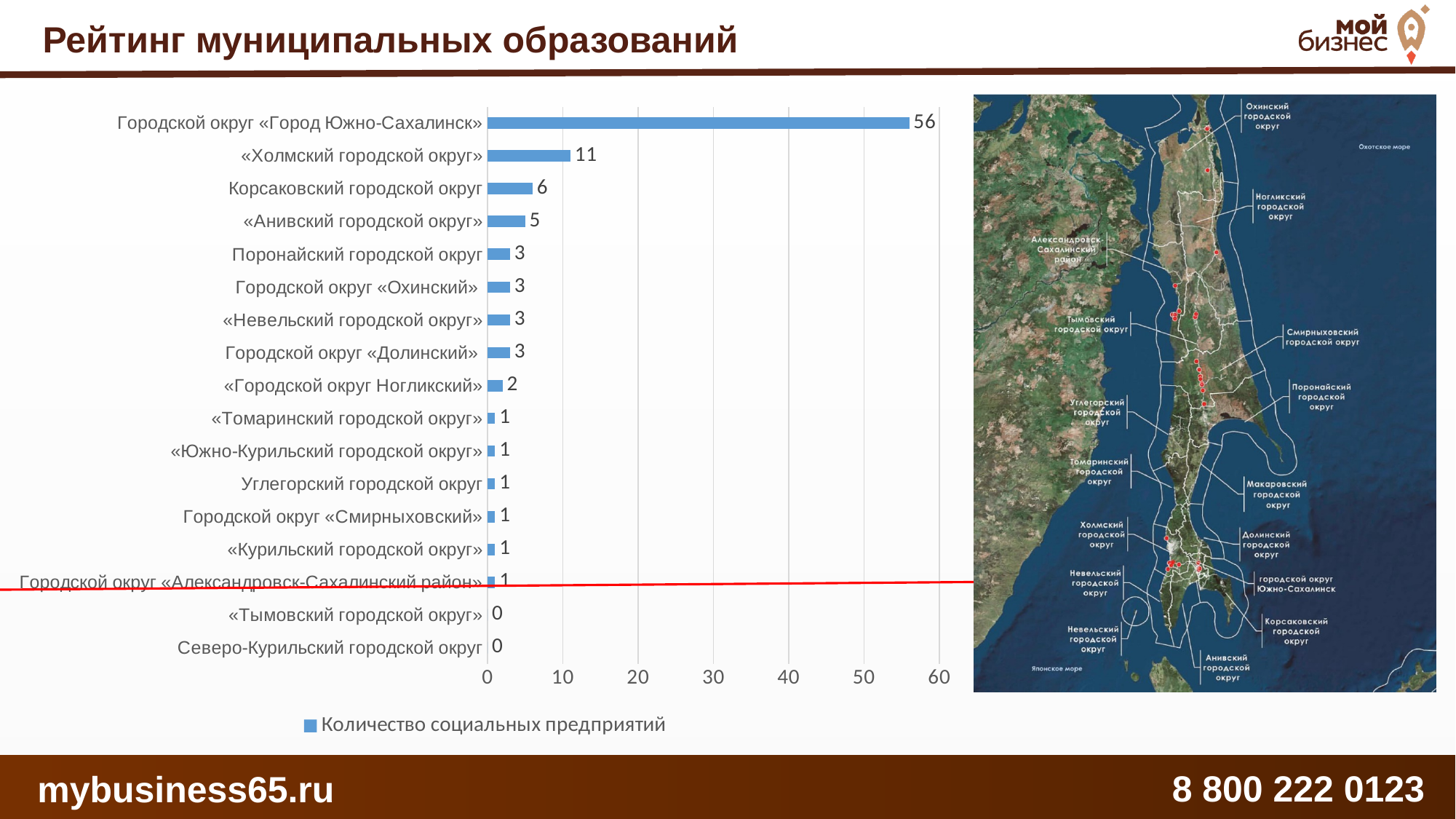
What is the value for Корсаковский городской округ? 6 What is the value for «Холмский городской округ»? 11 What is the legend entry of the chart? Количество социальных предприятий How many series does the legend list? 1 What is the difference between the values for Городской округ «Город Южно-Сахалинск» and «Холмский городской округ»? 45 What type of chart is shown on the slide? bar chart Is the value for Городской округ «Город Южно-Сахалинск» greater or less than 50? greater How many categories are shown on the chart? 17 What is the value for Городской округ «Город Южно-Сахалинск»? 56 What is the value for «Городской округ Ногликский»? 2 Which is larger, the value for «Анивский городской округ» or the value for Поронайский городской округ? «Анивский городской округ» Which category has the highest value? Городской округ «Город Южно-Сахалинск»